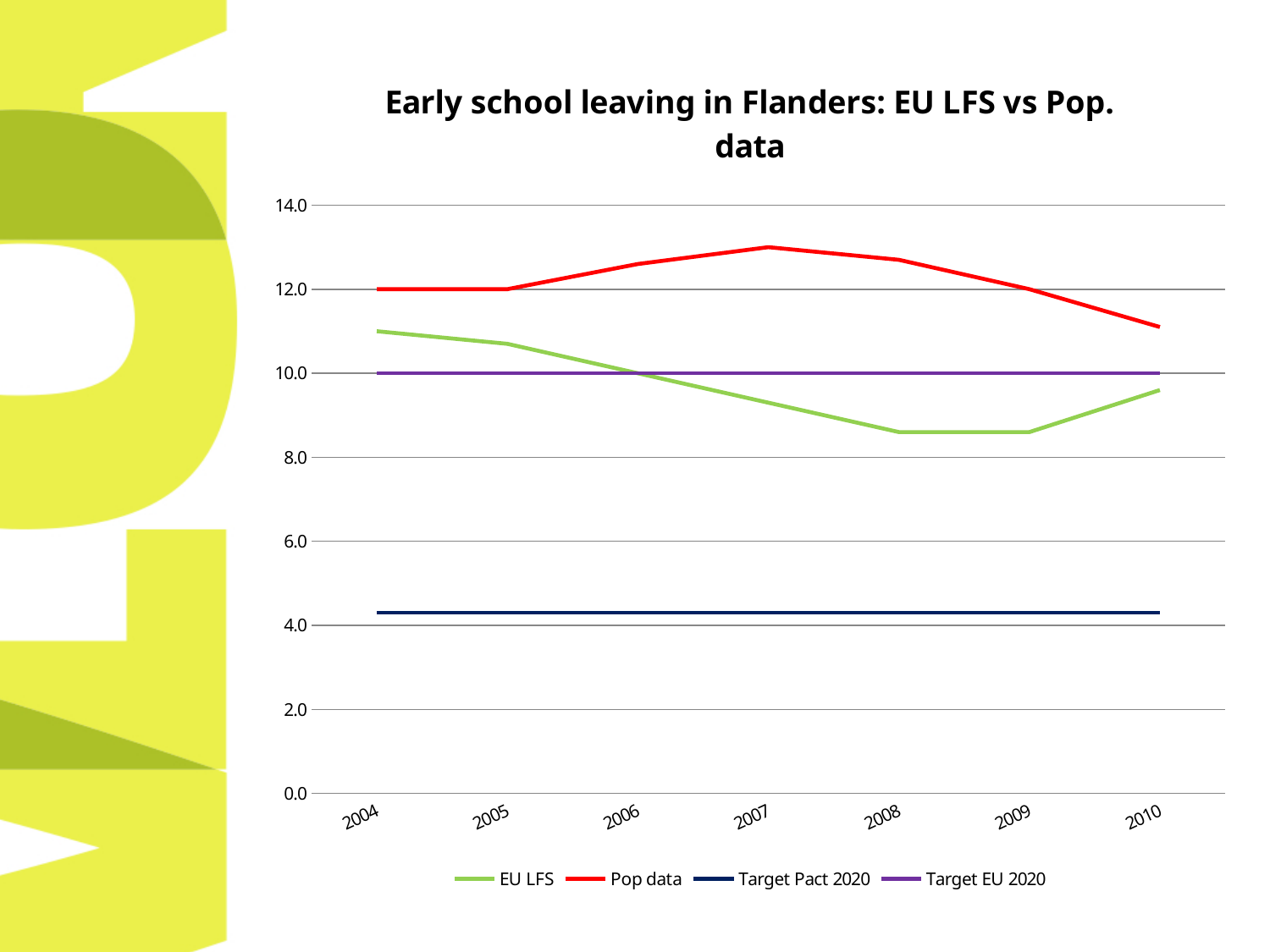
What value does the Target EU 2020 line sit at? 10.0 Does the EU LFS series rise or fall from 2004 to 2008? fall How many series does the legend list? 4 In 2010, which is larger: the Pop data value or the EU LFS value? Pop data What kind of chart is shown on the slide? line chart Is the Target Pact 2020 line greater or less than 6.0? less In which year does the Pop data series reach its highest value? 2007 Is the EU LFS value for 2008 greater or less than 10.0? less Is the Pop data value for 2007 greater or less than 12.0? greater What is the title of the chart? Early school leaving in Flanders: EU LFS vs Pop. data How many years are shown on the x axis? 7